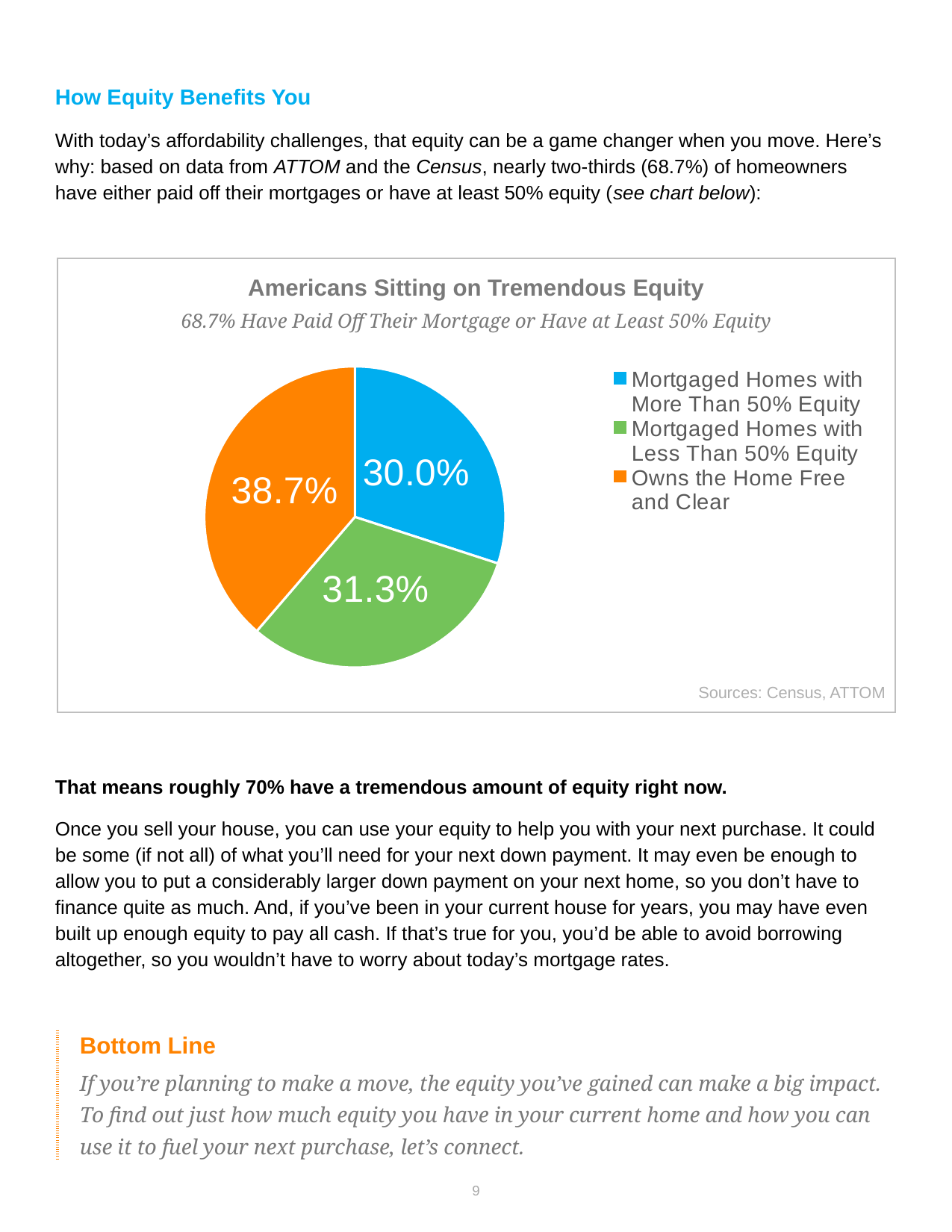
How many entries does the legend list? 3 What share of the pie is labelled for Mortgaged Homes with More Than 50% Equity? 30.0% Which is larger: the slice for Mortgaged Homes with Less Than 50% Equity or the slice for Mortgaged Homes with More Than 50% Equity? Mortgaged Homes with Less Than 50% Equity Which category has the largest slice of the pie? Owns the Home Free and Clear What share of the pie is labelled for Owns the Home Free and Clear? 38.7% What kind of chart is shown on the slide? Pie chart What is the difference in percentage points between the Owns the Home Free and Clear slice and the Mortgaged Homes with More Than 50% Equity slice? 8.7 Which category has the smallest slice of the pie? Mortgaged Homes with More Than 50% Equity What share of the pie is labelled for Mortgaged Homes with Less Than 50% Equity? 31.3% What is the title of the chart? Americans Sitting on Tremendous Equity How many slices does the pie chart have? 3 What colour is the slice for Owns the Home Free and Clear? Orange